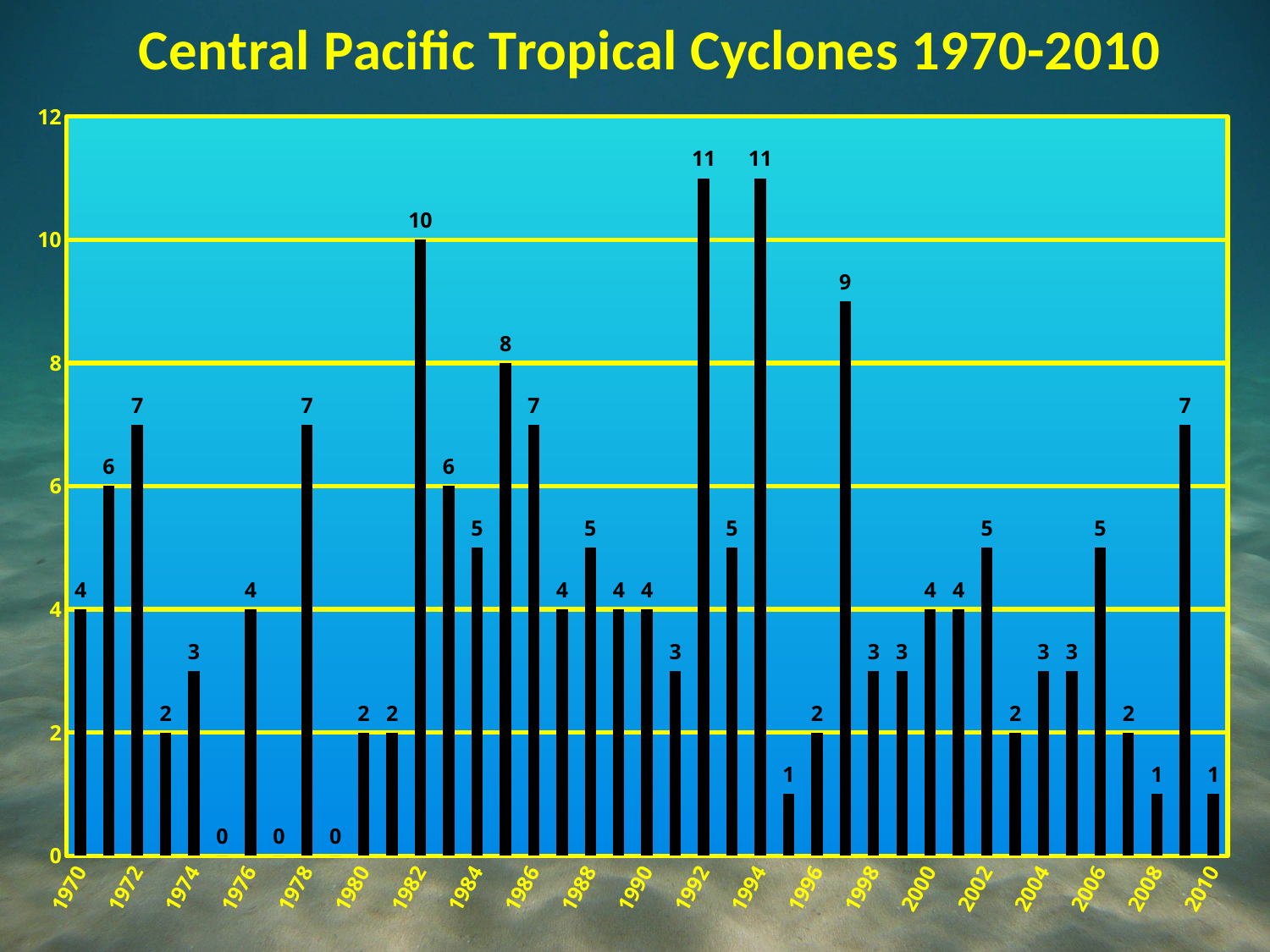
What is the value for 2000? 4 How many bars (years) are plotted on the chart? 41 What is the difference between the values for 1982 and 1980? 8 Is the value for 1978 greater or less than 6? greater What is the difference between the values for 1994 and 1996? 9 What kind of chart is shown on the slide? bar chart Which year has the larger value, 1984 or 1986? 1986 What is the value for 2010? 1 Which years have the highest number of tropical cyclones? 1992 and 1994 How many tropical cyclones are shown for 1982? 10 Do the values rise or fall from 1982 to 1984? fall What is the value for 1992? 11